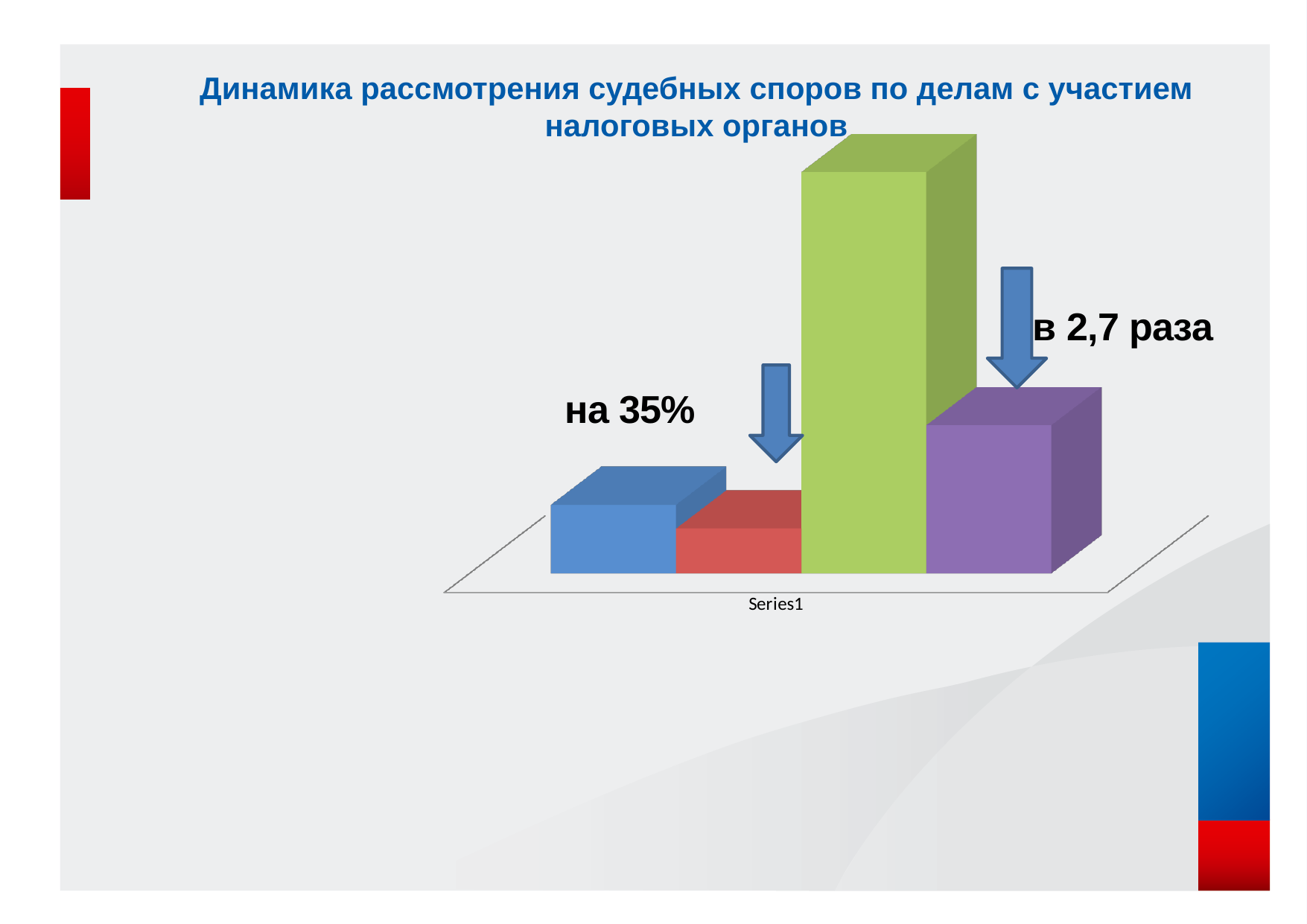
Which bar is the tallest in the chart? the green bar (third bar) Which is taller, the green bar or the purple bar? the green bar How many bars are plotted in the chart? 4 What is the title of the chart? Динамика рассмотрения судебных споров по делам с участием налоговых органов Which is taller, the red bar or the green bar? the green bar What kind of chart is shown on the slide? bar chart What text is written next to the arrow pointing down at the purple bar? в 2,7 раза Which is taller, the blue bar or the purple bar? the purple bar